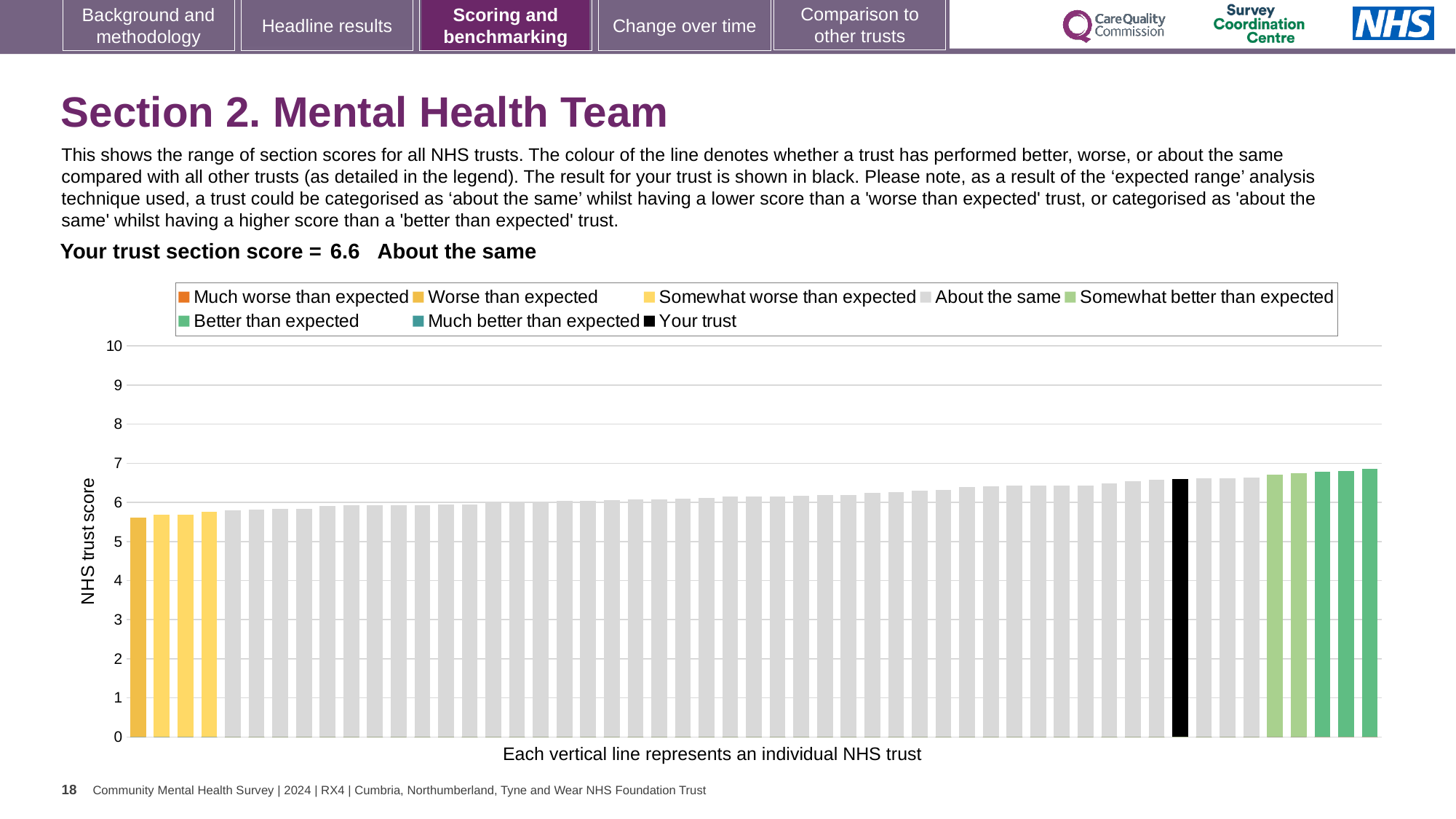
What kind of chart is shown on the slide? Bar chart What colour is the bar representing your trust? Black How many entries does the chart legend list? 8 Is the value of the rightmost bar greater or less than 7? less Do the bar values rise or fall from left to right along the x axis? Rise How is the trust's section score categorised relative to other trusts? About the same Is the value of the leftmost bar greater or less than 6? less What is the label on the vertical axis of the chart? NHS trust score What is the highest value shown on the vertical axis of the chart? 10 Which is larger: the value of the black bar (your trust) or the value of the leftmost bar? The black bar (your trust) Is the value of the black bar (your trust) greater or less than 6? greater What is the trust's section score shown on the slide? 6.6